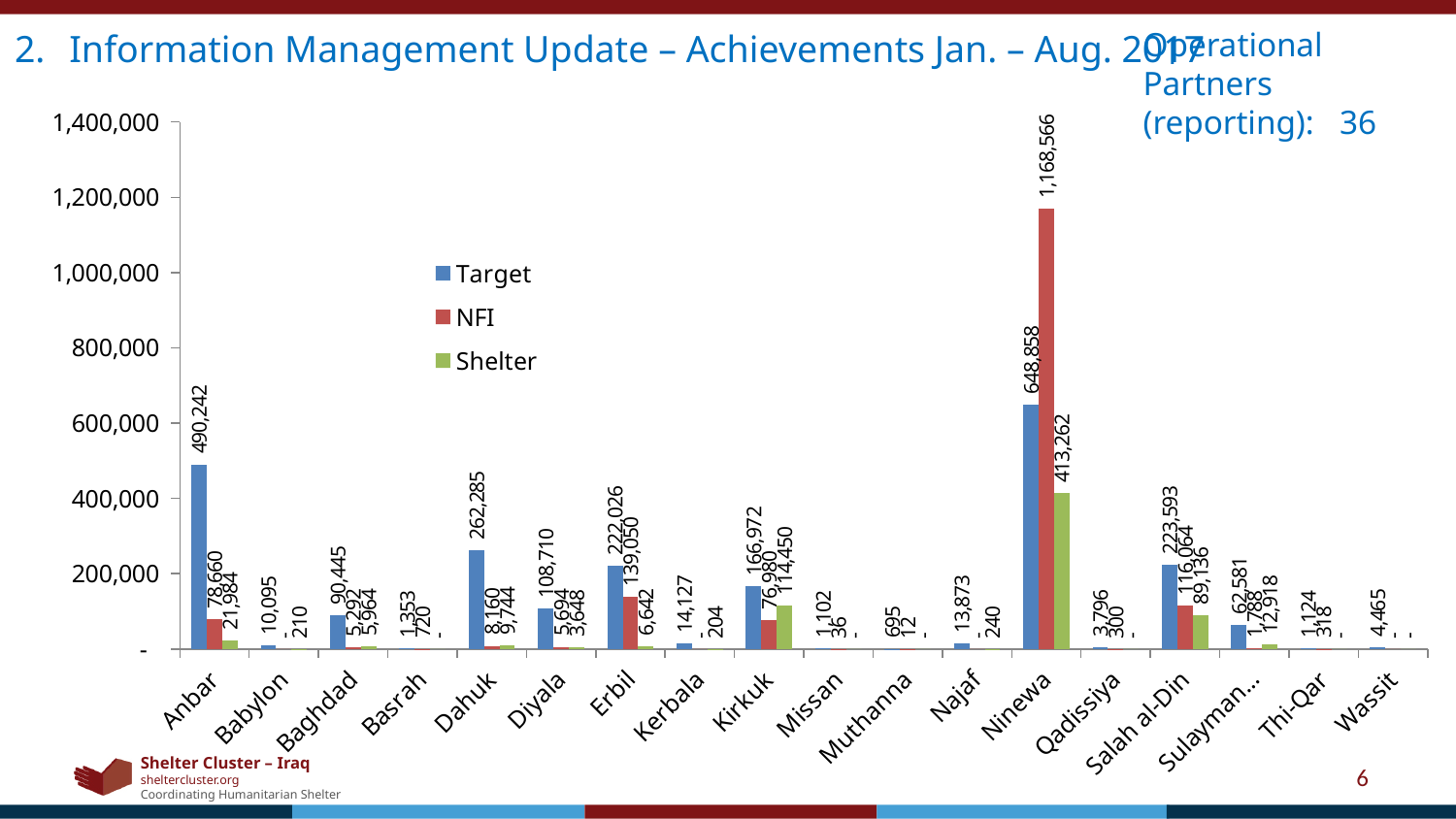
What is the NFI value for Ninewa? 1,168,566 What is the Target value for Dahuk? 262,285 What kind of chart is shown on the slide? bar chart Which governorate has the highest NFI value? Ninewa How many governorates (categories) are shown on the x axis? 18 What is the Shelter value for Ninewa? 413,262 Which is larger, the Target value for Anbar or the Target value for Dahuk? Anbar Is the NFI value for Ninewa greater or less than 1,000,000? greater What is the difference between the NFI value and the Target value for Ninewa? 519,708 Which governorate has the highest Target value? Ninewa How many series does the legend list? 3 What is the Target value for Anbar? 490,242